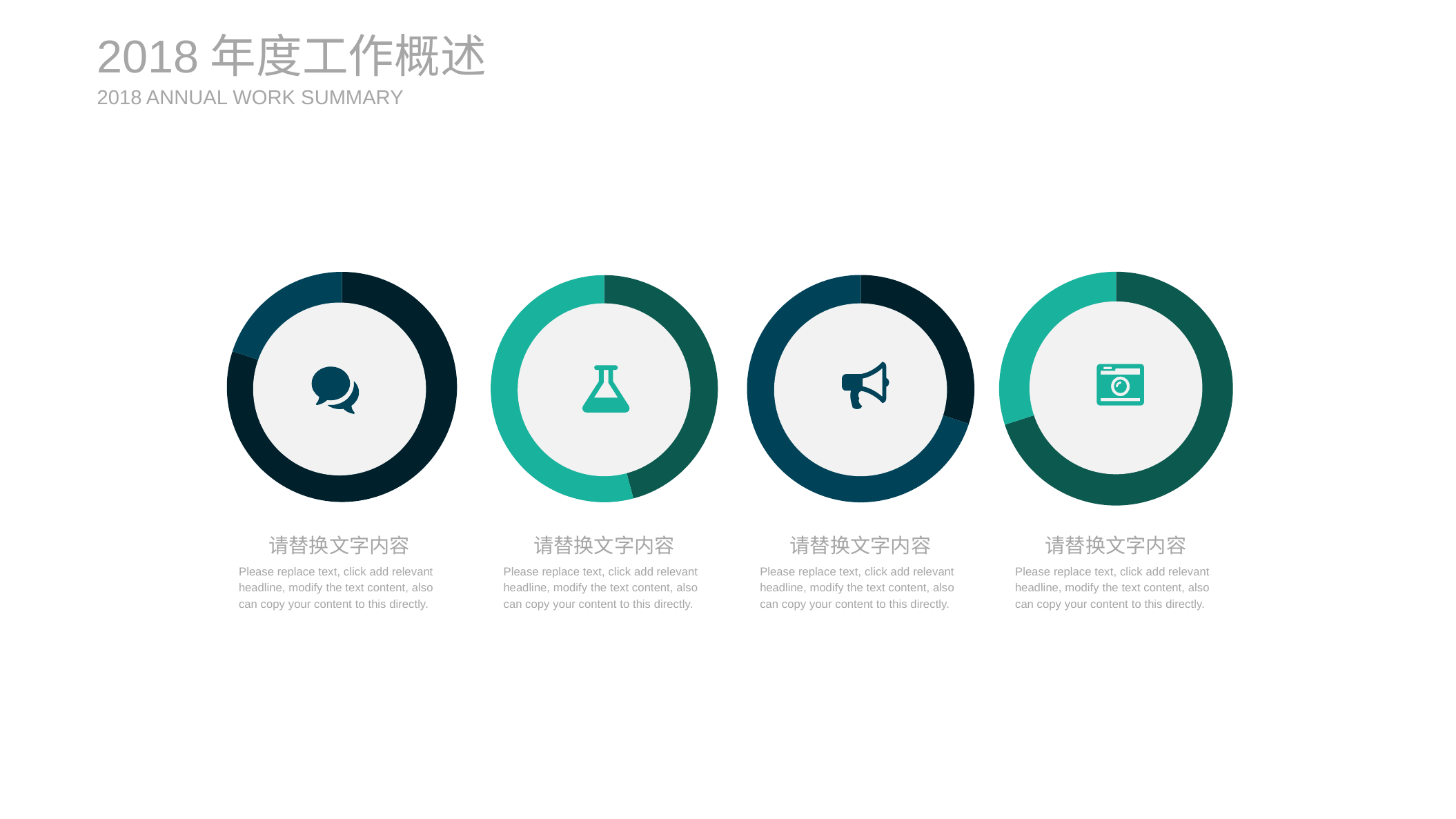
How many donut charts are shown on the slide? 4 In the third donut chart from the left (megaphone icon), which segment is larger, the dark navy one or the lighter blue one? The lighter blue one What icon is shown in the centre of the second donut chart from the left? A flask In the leftmost donut chart (speech-bubble icon), which segment is larger, the dark navy one or the lighter blue one? The dark navy one In the rightmost donut chart (camera icon), how many segments does the ring have? 2 In the leftmost donut chart (speech-bubble icon), how many segments does the ring have? 2 In the rightmost donut chart (camera icon), which segment is larger, the light teal one or the dark green one? The dark green one Do any of the donut charts on the slide display data labels or a legend? No What kind of chart is the leftmost chart on the slide (the one with the speech-bubble icon)? Donut chart